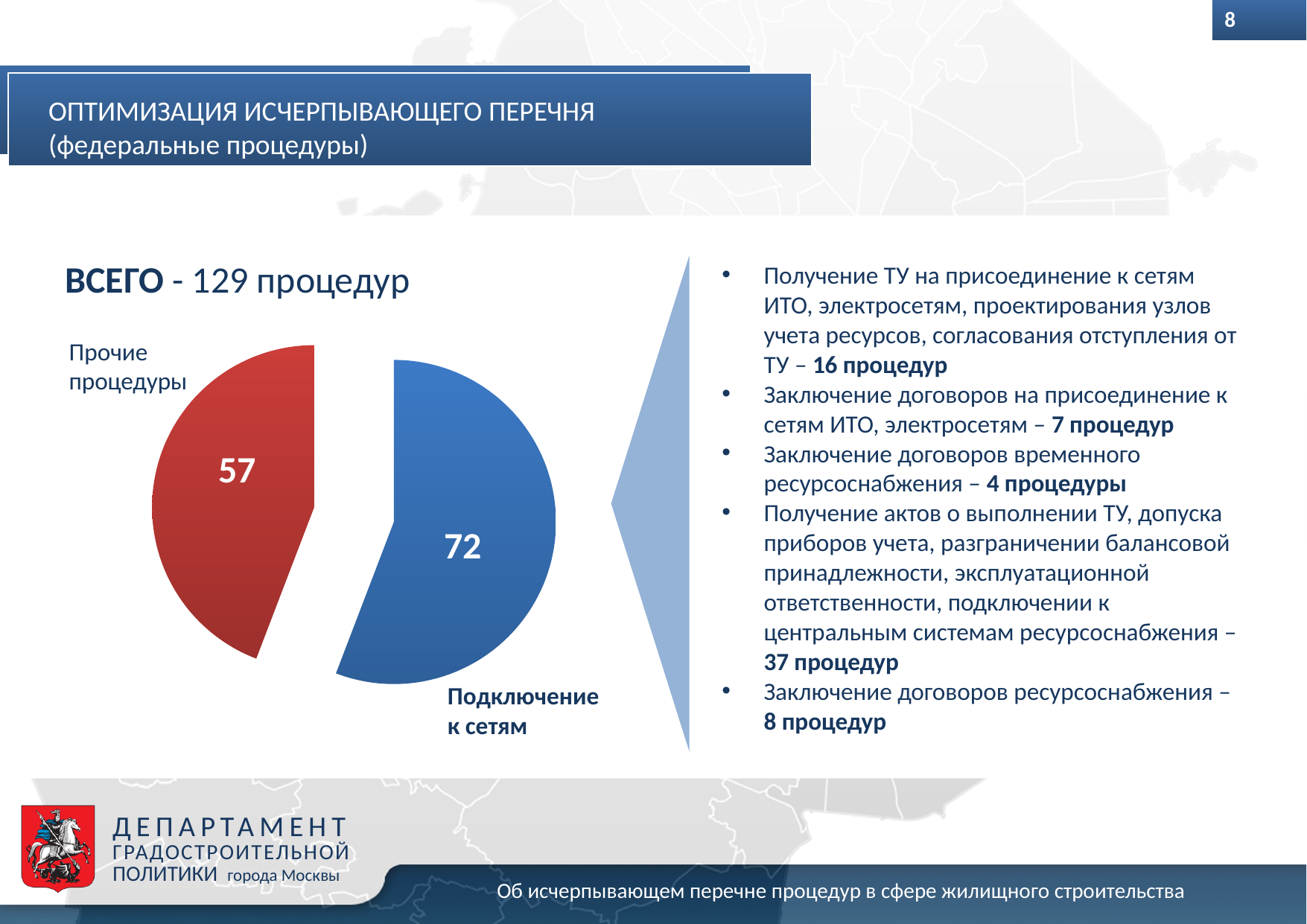
What is the value of the "Подключение к сетям" slice in the pie chart? 72 What colour is the "Прочие процедуры" slice in the pie chart? red Which slice of the pie chart is the largest? Подключение к сетям How many slices does the pie chart have? 2 What colour is the "Подключение к сетям" slice in the pie chart? blue What type of chart is shown on the slide? pie chart What is the value of the "Прочие процедуры" slice in the pie chart? 57 Which slice of the pie chart is the smallest? Прочие процедуры What is the total number of procedures represented by the pie chart, as stated on the slide? 129 процедур Which is larger in the pie chart: "Прочие процедуры" or "Подключение к сетям"? Подключение к сетям What is the difference between the "Подключение к сетям" and "Прочие процедуры" slices? 15